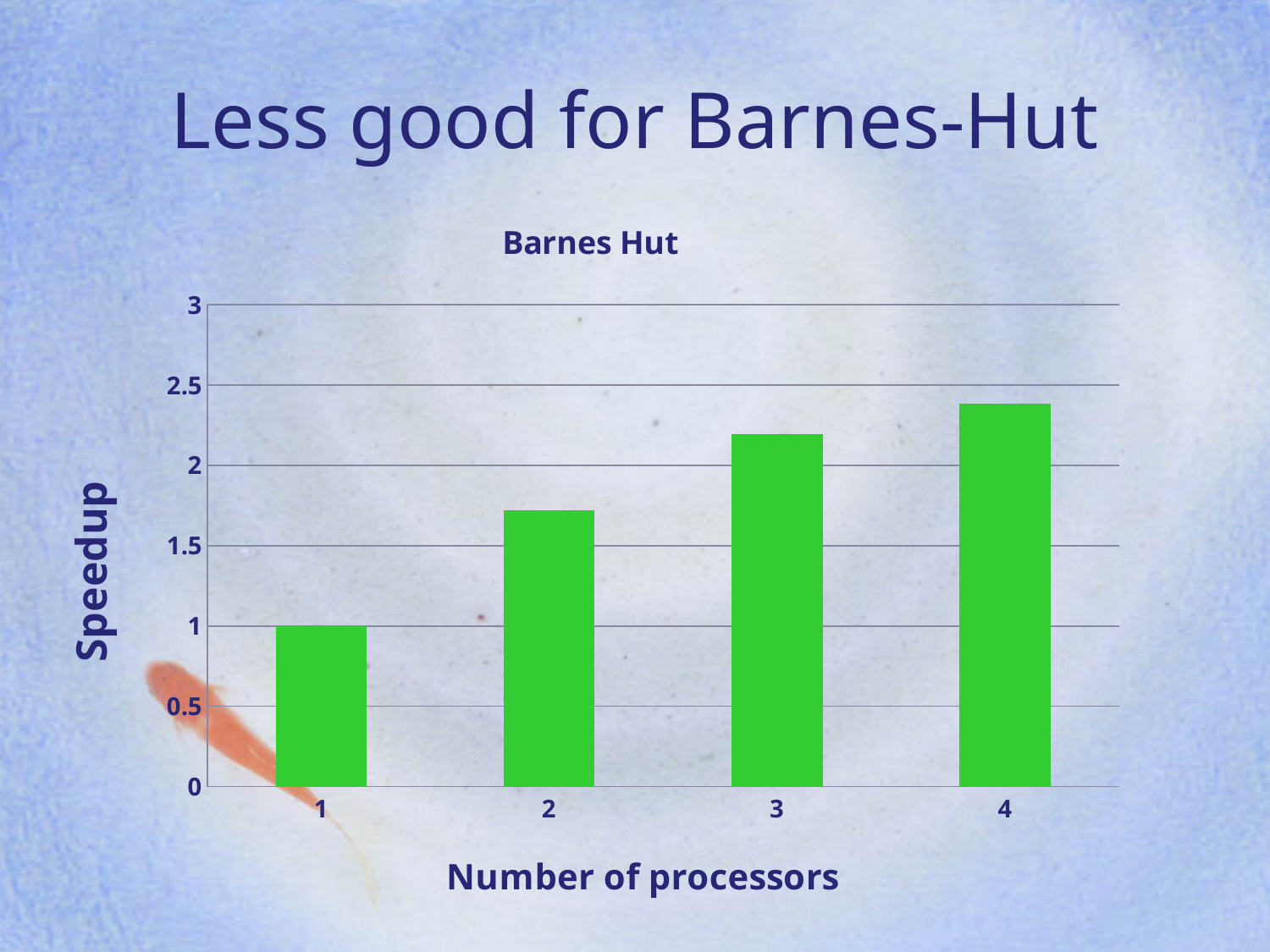
What is the title of the chart? Barnes Hut Which number of processors has the lowest speedup? 1 What is the label of the vertical axis? Speedup Does the speedup rise or fall as the number of processors increases? rise What is the speedup for 1 processor? 1 Is the speedup for 4 processors greater or less than 2.5? less Which number of processors has the highest speedup? 4 Is the speedup for 2 processors greater or less than 1.5? greater Is the speedup for 2 processors greater or less than 2? less Which has a larger speedup, 3 processors or 2 processors? 3 processors How many bars (numbers of processors) are plotted in the chart? 4 What type of chart is shown on the slide? bar chart